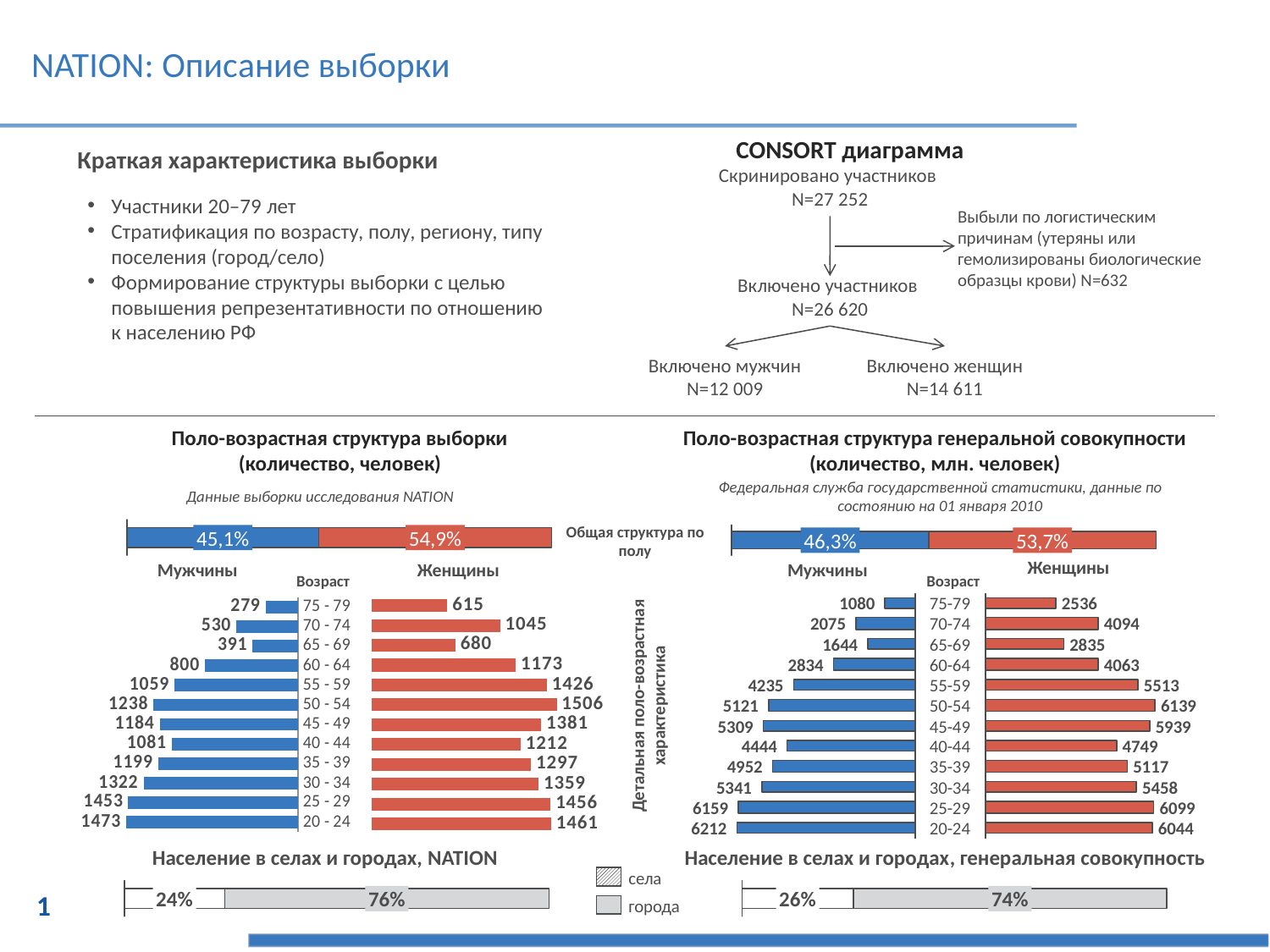
In the chart 'Поло-возрастная структура генеральной совокупности', which is larger: men aged 45-49 or men aged 40-44? men aged 45-49 In the chart 'Поло-возрастная структура генеральной совокупности', which age group has the highest value for women? 50-54 In the chart 'Население в селах и городах, генеральная совокупность', what share is 'села'? 26% In the chart 'Поло-возрастная структура выборки', which age group has the highest number of women? 50 - 54 How many age groups are shown in the chart 'Поло-возрастная структура выборки'? 12 In the chart 'Поло-возрастная структура выборки', what is the difference between the number of women and men aged 50 - 54? 268 In the bar 'Общая структура по полу' for the NATION sample (left), what share is women? 54,9% In the chart 'Поло-возрастная структура выборки', what is the number of men aged 20 - 24? 1473 In the chart 'Поло-возрастная структура генеральной совокупности', what is the value for women aged 75-79? 2536 In the chart 'Поло-возрастная структура генеральной совокупности', what is the value for men aged 20-24? 6212 In the chart 'Поло-возрастная структура выборки', what is the number of women aged 50 - 54? 1506 In the chart 'Поло-возрастная структура выборки', which age group has the lowest number of men? 75 - 79